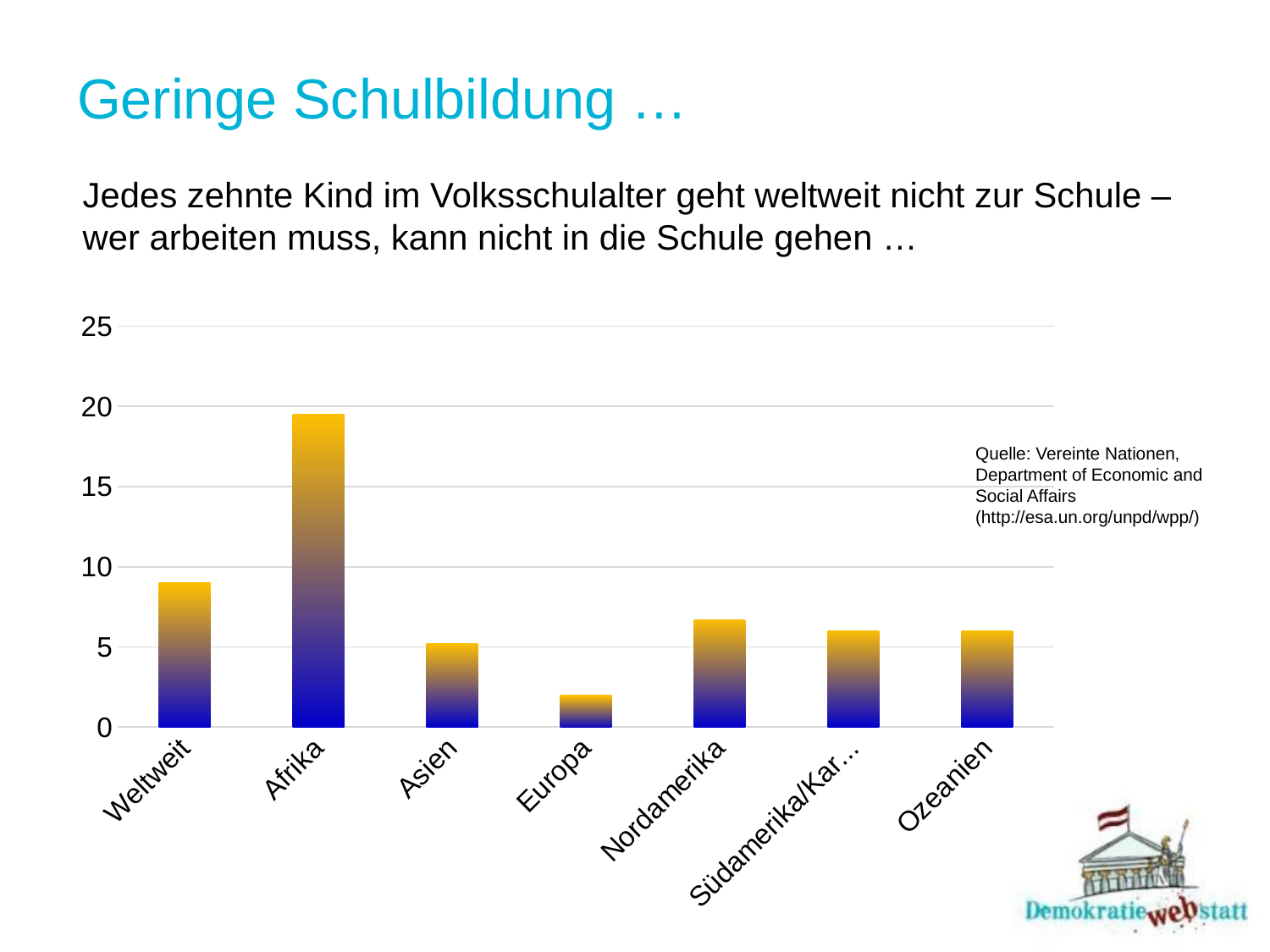
How many categories are shown on the x axis of the chart? 7 Which category has the lowest bar in the chart? Europa Is the value for Weltweit greater or less than 10? less Is the value for Weltweit greater or less than 5? greater Which has the larger value, Weltweit or Nordamerika? Weltweit What kind of chart is shown on the slide? bar chart Which category has the highest bar in the chart? Afrika According to the note on the slide, which organisation is the source of the chart data? Vereinte Nationen, Department of Economic and Social Affairs Which has the larger value, Asien or Europa? Asien Is the value for Afrika greater or less than 15? greater